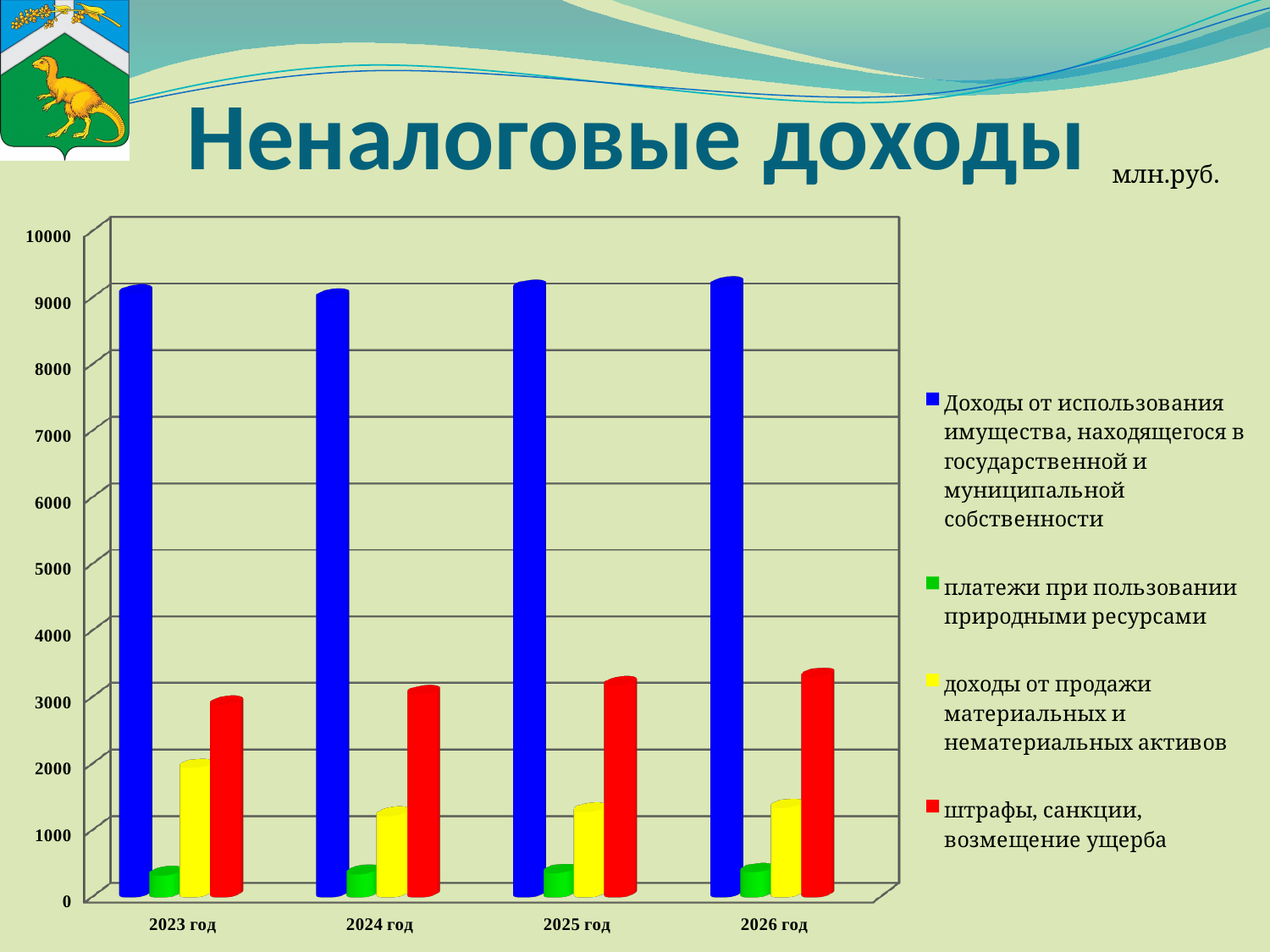
In 2024 год, which is larger: 'штрафы, санкции, возмещение ущерба' or 'доходы от продажи материальных и нематериальных активов'? штрафы, санкции, возмещение ущерба What is the title of the chart? Неналоговые доходы How many series does the legend list? 4 How many year categories are shown on the x axis? 4 Do the values for 'штрафы, санкции, возмещение ущерба' rise or fall from 2023 год to 2026 год? rise What unit is indicated for the chart values? млн.руб. Which series has the highest value in 2023 год? Доходы от использования имущества, находящегося в государственной и муниципальной собственности Which series has the lowest value in 2026 год? платежи при пользовании природными ресурсами Is the value for 'штрафы, санкции, возмещение ущерба' in 2026 год greater or less than 3000? greater Is the value for 'Доходы от использования имущества, находящегося в государственной и муниципальной собственности' in 2024 год greater or less than 8000? greater Is the value for 'платежи при пользовании природными ресурсами' in 2024 год greater or less than 1000? less What kind of chart is shown on the slide? bar chart